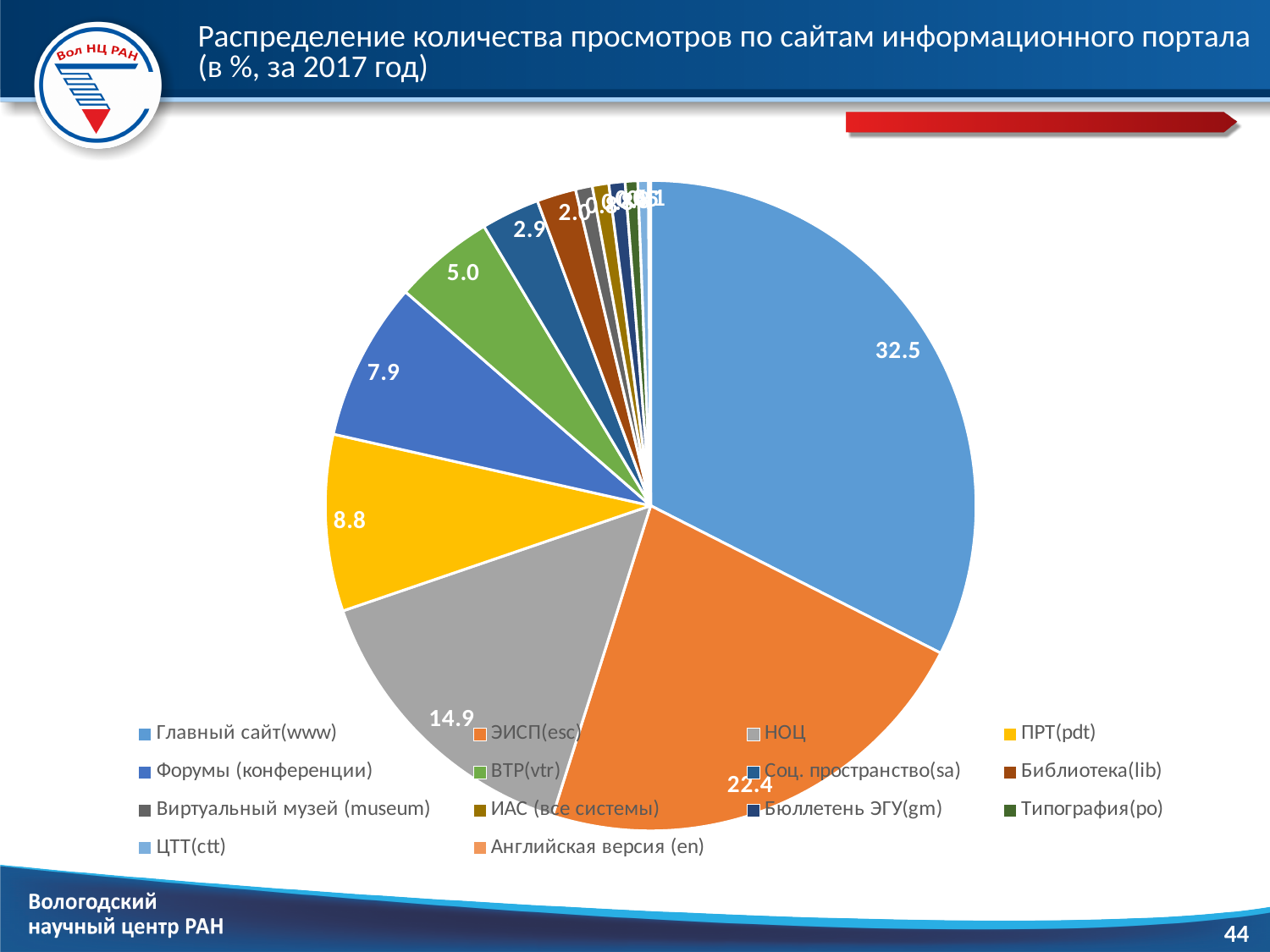
What is the value shown for ВТР(vtr)? 5.0 What percentage of views does Главный сайт(www) account for? 32.5 For which year does the chart show the distribution of views? 2017 Which has a larger share of views: ПРТ(pdt) or Форумы (конференции)? ПРТ(pdt) Which site has the largest share of views in the pie chart? Главный сайт(www) What is the value shown for НОЦ? 14.9 What kind of chart is shown on the slide? pie chart What is the value shown for ЭИСП(esc)? 22.4 How many sites are listed in the chart legend? 14 What is the difference between the shares of Главный сайт(www) and ЭИСП(esc)? 10.1 What is the value shown for Форумы (конференции)? 7.9 What is the value shown for ПРТ(pdt)? 8.8